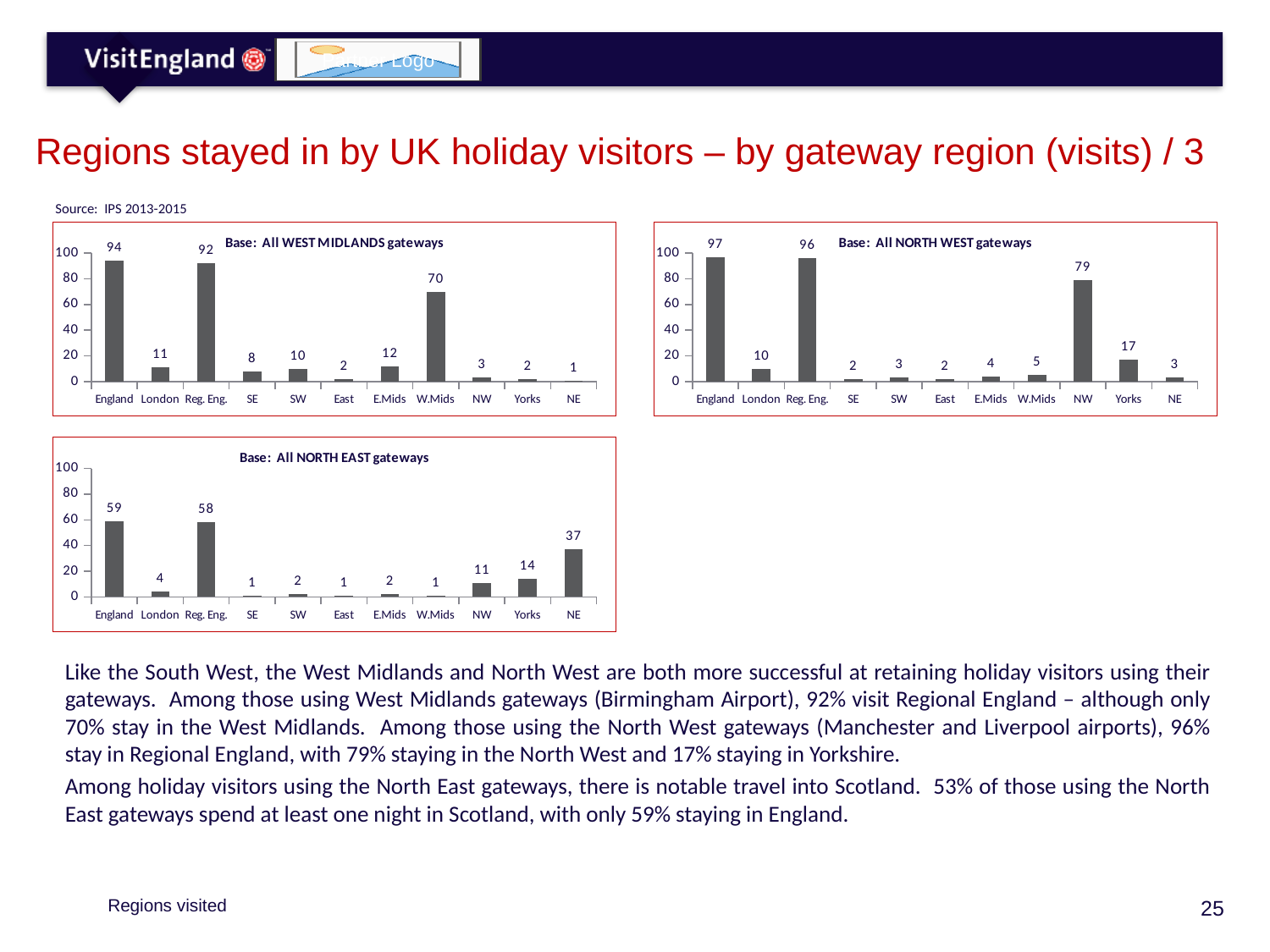
In the 'Base: All NORTH EAST gateways' chart, what is the value for NE? 37 In the 'Base: All NORTH WEST gateways' chart, which is larger, the value for Yorks or the value for London? Yorks In the 'Base: All NORTH EAST gateways' chart, is the value for England greater or less than 40? greater In the 'Base: All NORTH EAST gateways' chart, what is the difference between the values for NE and Yorks? 23 In the 'Base: All WEST MIDLANDS gateways' chart, which category has the lowest value? NE How many categories are shown on the x axis of the 'Base: All WEST MIDLANDS gateways' chart? 11 In the 'Base: All NORTH WEST gateways' chart, what is the difference between the values for England and Reg. Eng.? 1 How many charts are shown on the slide? 3 In the 'Base: All NORTH WEST gateways' chart, what is the value for NW? 79 In the 'Base: All WEST MIDLANDS gateways' chart, what is the value for W.Mids? 70 In the 'Base: All NORTH WEST gateways' chart, which category has the highest value? England What type of chart is the 'Base: All NORTH EAST gateways' chart? Bar chart